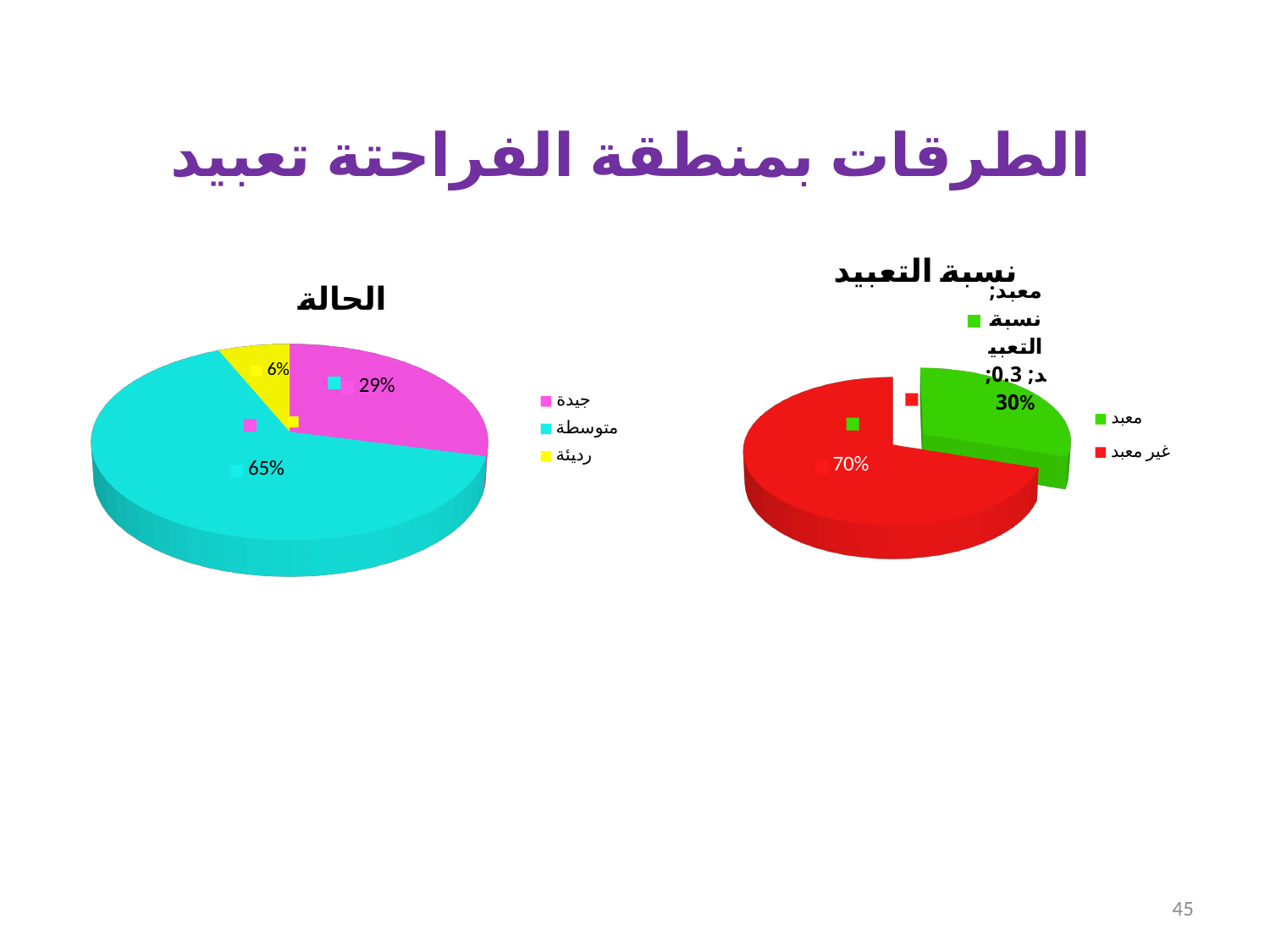
What type of chart is the chart titled "نسبة التعبيد"? Pie chart In the chart titled "نسبة التعبيد", what colour is the slice for "معبد"? Green In the chart titled "نسبة التعبيد", which category is larger, "معبد" or "غير معبد"? غير معبد In the chart titled "الحالة", what percentage is shown for the category "رديئة"? 6% In the chart titled "الحالة", which category has the largest slice? متوسطة In the chart titled "نسبة التعبيد", what percentage is shown for "معبد"? 30% In the chart titled "الحالة", what percentage is shown for the category "جيدة"? 29% In the chart titled "الحالة", what is the difference in percentage points between "متوسطة" and "جيدة"? 36 In the chart titled "نسبة التعبيد", what percentage is shown for "غير معبد"? 70% In the chart titled "الحالة", what percentage is shown for the category "متوسطة"? 65% In the chart titled "الحالة", which category has the smallest slice? رديئة In the chart titled "الحالة", how many categories does the legend list? 3